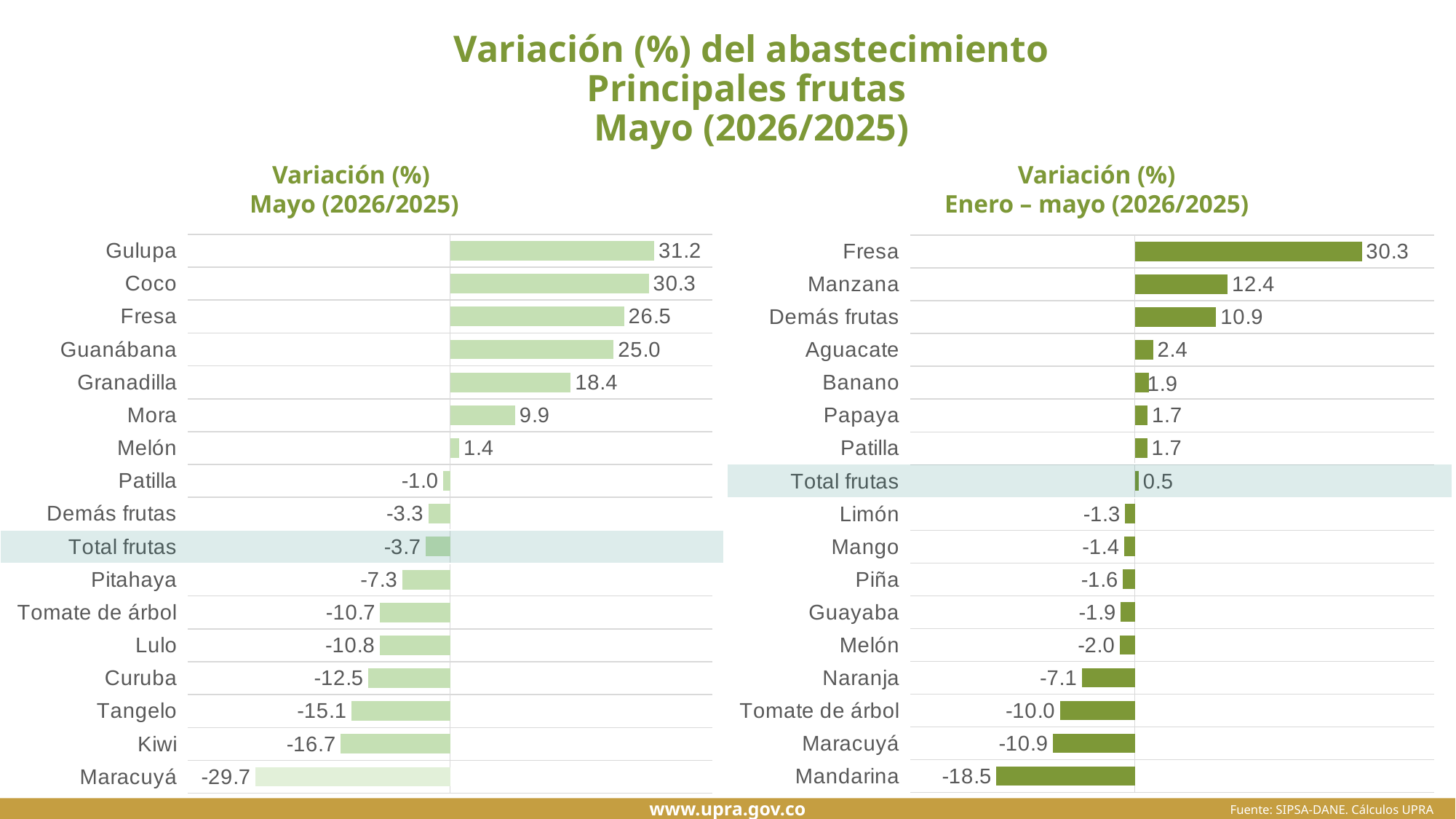
What kind of chart is used on this slide? Bar chart In the right chart (Variación (%) Enero – mayo (2026/2025)), what is the value for Manzana? 12.4 In the left chart (Variación (%) Mayo (2026/2025)), what is the value for Total frutas? -3.7 In the right chart (Variación (%) Enero – mayo (2026/2025)), which fruit has the highest value? Fresa In the right chart (Variación (%) Enero – mayo (2026/2025)), which fruit has the lowest value? Mandarina In the left chart (Variación (%) Mayo (2026/2025)), what is the difference between the values for Gulupa and Coco? 0.9 In the left chart (Variación (%) Mayo (2026/2025)), which fruit has the lowest value? Maracuyá In the right chart (Variación (%) Enero – mayo (2026/2025)), what is the value for Total frutas? 0.5 In the left chart (Variación (%) Mayo (2026/2025)), how many categories are shown? 17 In the right chart (Variación (%) Enero – mayo (2026/2025)), what is the difference between the values for Fresa and Manzana? 17.9 In the left chart (Variación (%) Mayo (2026/2025)), what is the value for Gulupa? 31.2 In the right chart (Variación (%) Enero – mayo (2026/2025)), which is larger, the value for Naranja or the value for Tomate de árbol? Naranja